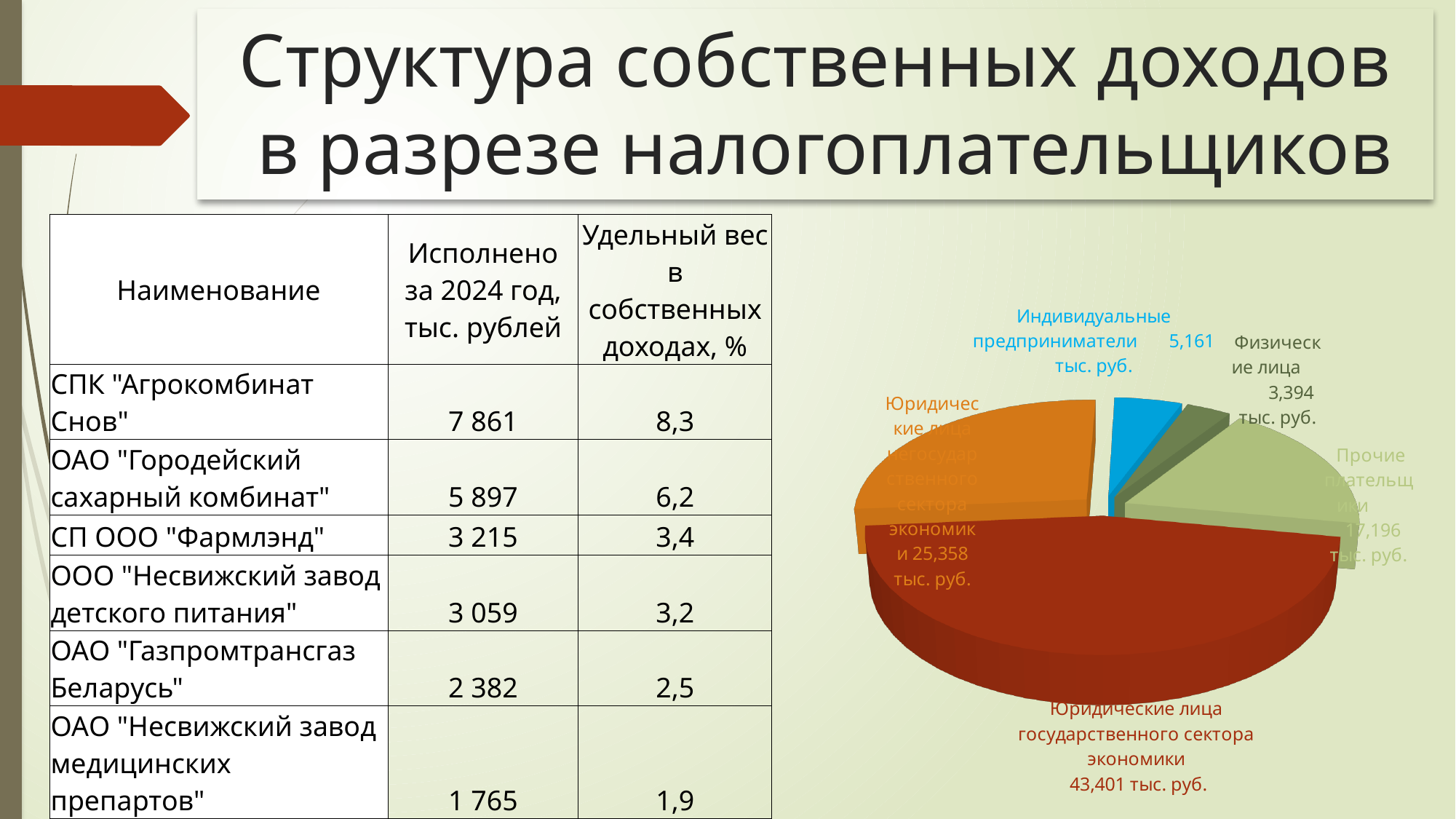
What is the value shown for "Юридические лица негосударственного сектора экономики" in the pie chart? 25,358 тыс. руб. What is the value shown for "Юридические лица государственного сектора экономики" in the pie chart? 43,401 тыс. руб. In the pie chart, what is the difference between "Юридические лица государственного сектора экономики" and "Юридические лица негосударственного сектора экономики"? 18,043 тыс. руб. In the pie chart, which is larger: "Прочие плательщики" or "Юридические лица негосударственного сектора экономики"? Юридические лица негосударственного сектора экономики What kind of chart is shown on the right side of the slide? pie chart What is the value shown for "Индивидуальные предприниматели" in the pie chart? 5,161 тыс. руб. Which category has the smallest slice in the pie chart? Физические лица In the pie chart, what is the difference between "Индивидуальные предприниматели" and "Физические лица"? 1,767 тыс. руб. How many slices does the pie chart have? 5 What is the value shown for "Физические лица" in the pie chart? 3,394 тыс. руб. What is the value shown for "Прочие плательщики" in the pie chart? 17,196 тыс. руб. Which category has the largest slice in the pie chart? Юридические лица государственного сектора экономики